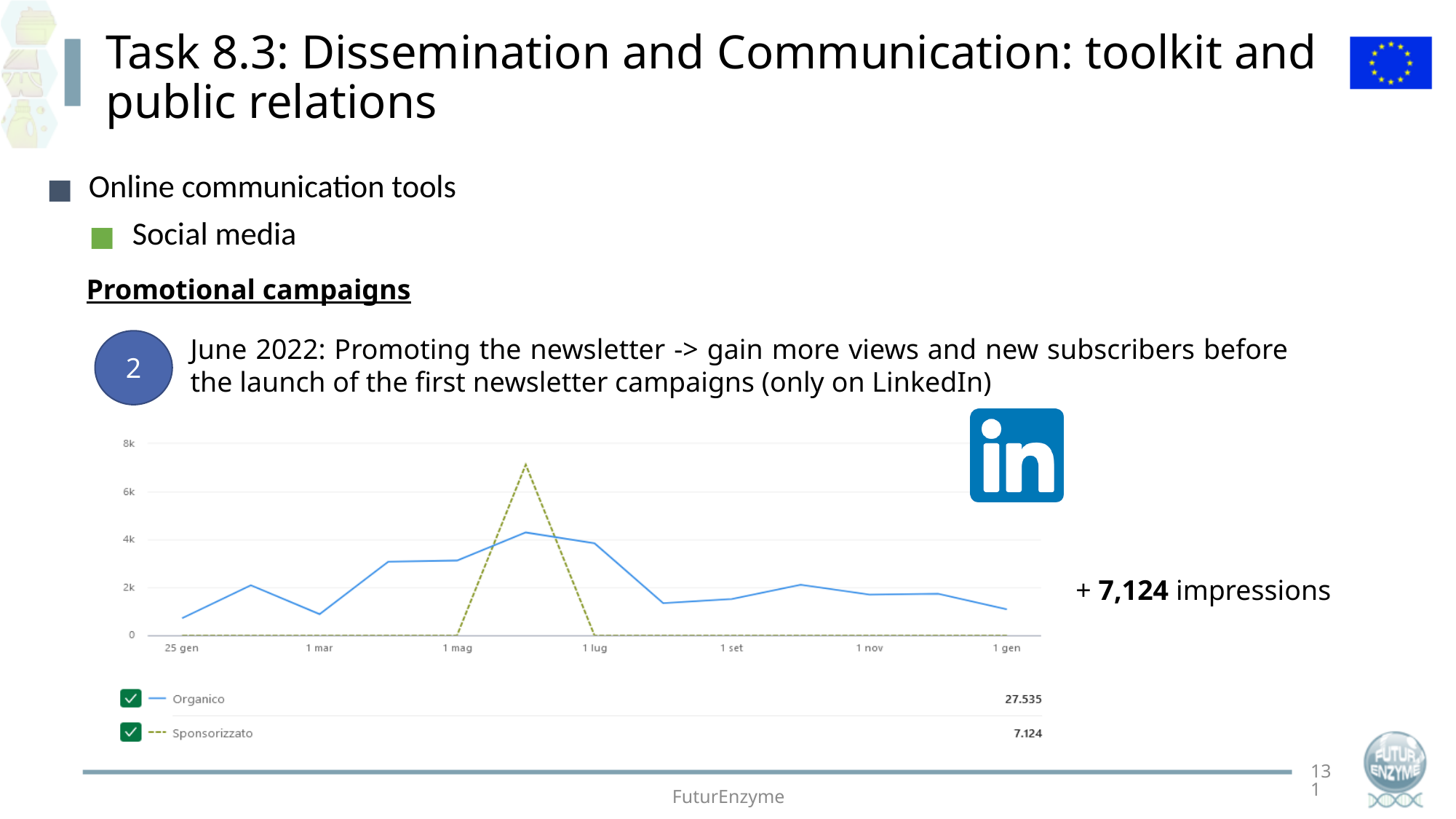
How many series does the chart's legend list? 2 Which series reaches the highest peak on the chart? Sponsorizzato Which series has the larger total shown in the legend, Organico or Sponsorizzato? Organico What total is shown next to the Organico series in the legend? 27.535 How many labelled tick marks are on the x axis of the chart? 7 What total is shown next to the Sponsorizzato series in the legend? 7.124 What kind of chart is shown on the slide? line chart What is the difference between the Organico total and the Sponsorizzato total shown in the legend? 20.411 Is the peak value of the Sponsorizzato series greater or less than 6k? greater What is the Sponsorizzato value at 25 gen? 0 What are the two series named in the chart's legend? Organico and Sponsorizzato Is the Organico value at 1 mar greater or less than 2k? less